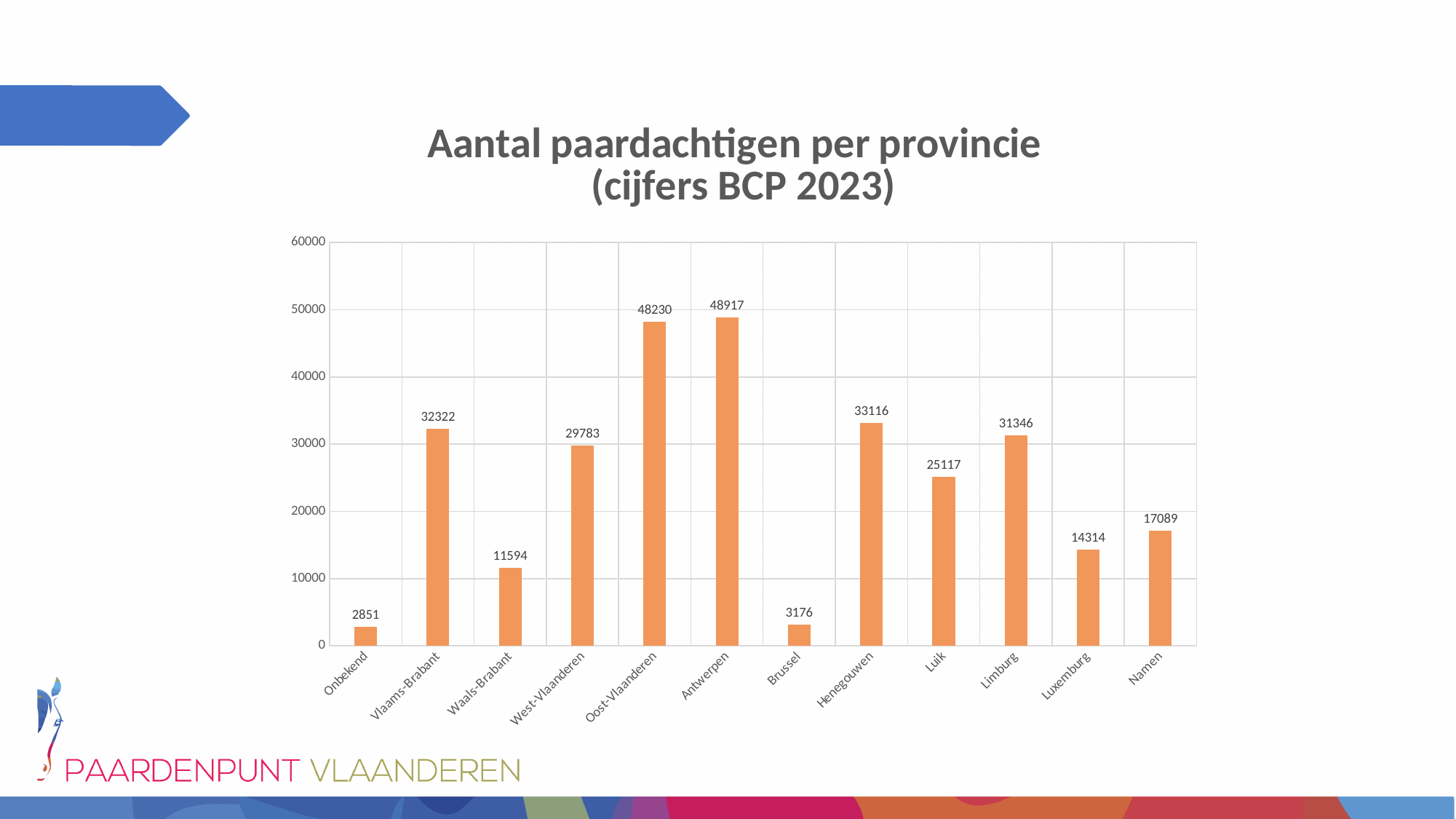
What is the value for Antwerpen? 48917 Which is larger, the value for Vlaams-Brabant or the value for Limburg? Vlaams-Brabant Which province has the highest number of paardachtigen? Antwerpen What is the value for Luik? 25117 What is the difference between the values for Henegouwen and Luik? 7999 Which category has the lowest value? Onbekend What is the value for Waals-Brabant? 11594 What is the difference between the values for Antwerpen and Oost-Vlaanderen? 687 What is the title of the chart? Aantal paardachtigen per provincie (cijfers BCP 2023) What kind of chart is shown on the slide? bar chart How many categories are shown on the x axis? 12 Is the value for Namen greater or less than 20000? less